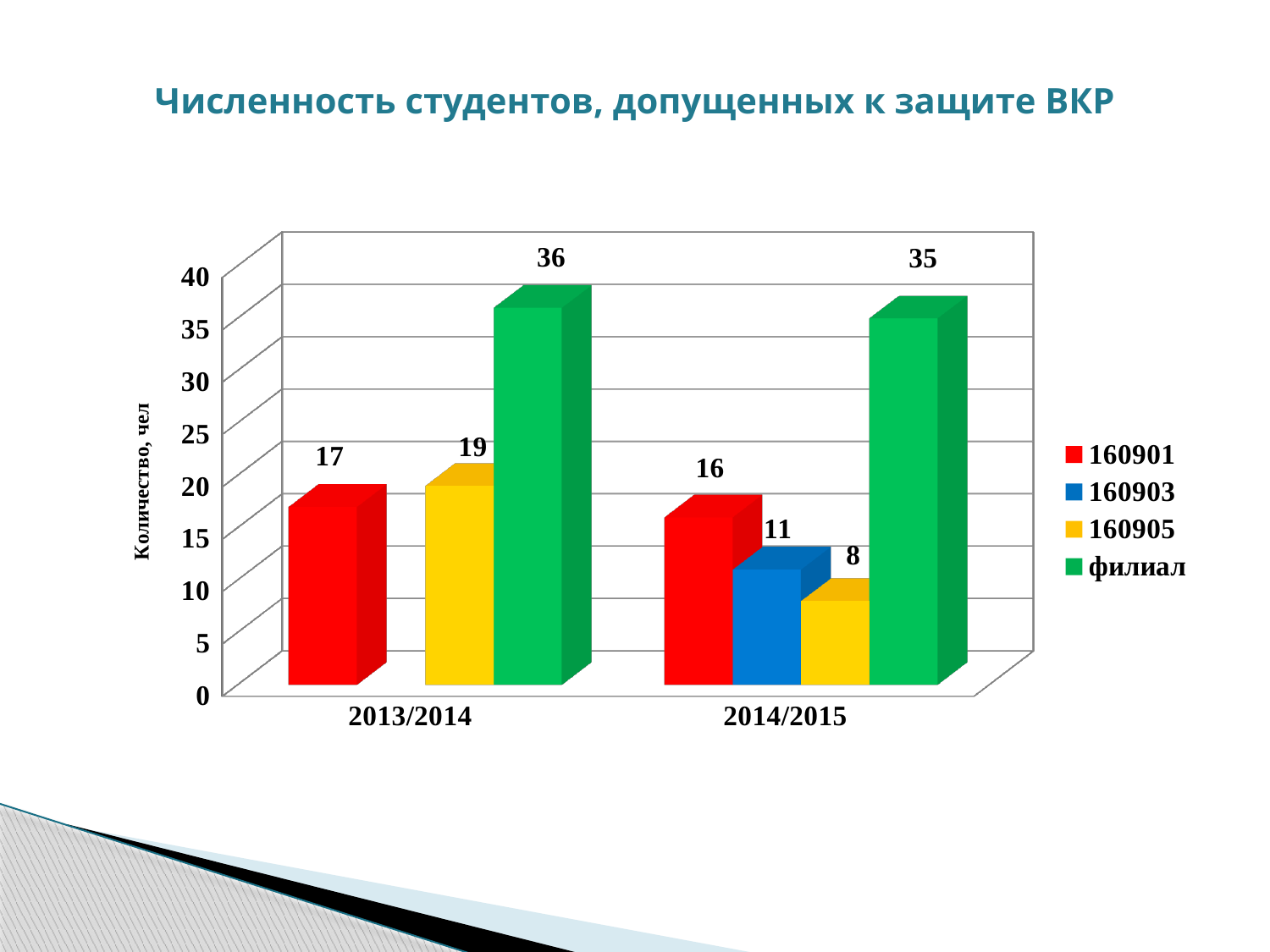
How many series does the legend list? 4 Which is larger: the value for 160905 in 2013/2014 or in 2014/2015? 2013/2014 Which series has the lowest value in 2014/2015? 160905 What kind of chart is shown on the slide? bar chart What is the value for 160905 in 2013/2014? 19 What is the value for 160903 in 2014/2015? 11 What is the value for филиал in 2014/2015? 35 What is the difference between the филиал values for 2013/2014 and 2014/2015? 1 What is the label of the vertical axis? Количество, чел What is the value for 160901 in 2013/2014? 17 Which series has the highest value in 2013/2014? филиал How many categories are shown on the x axis? 2